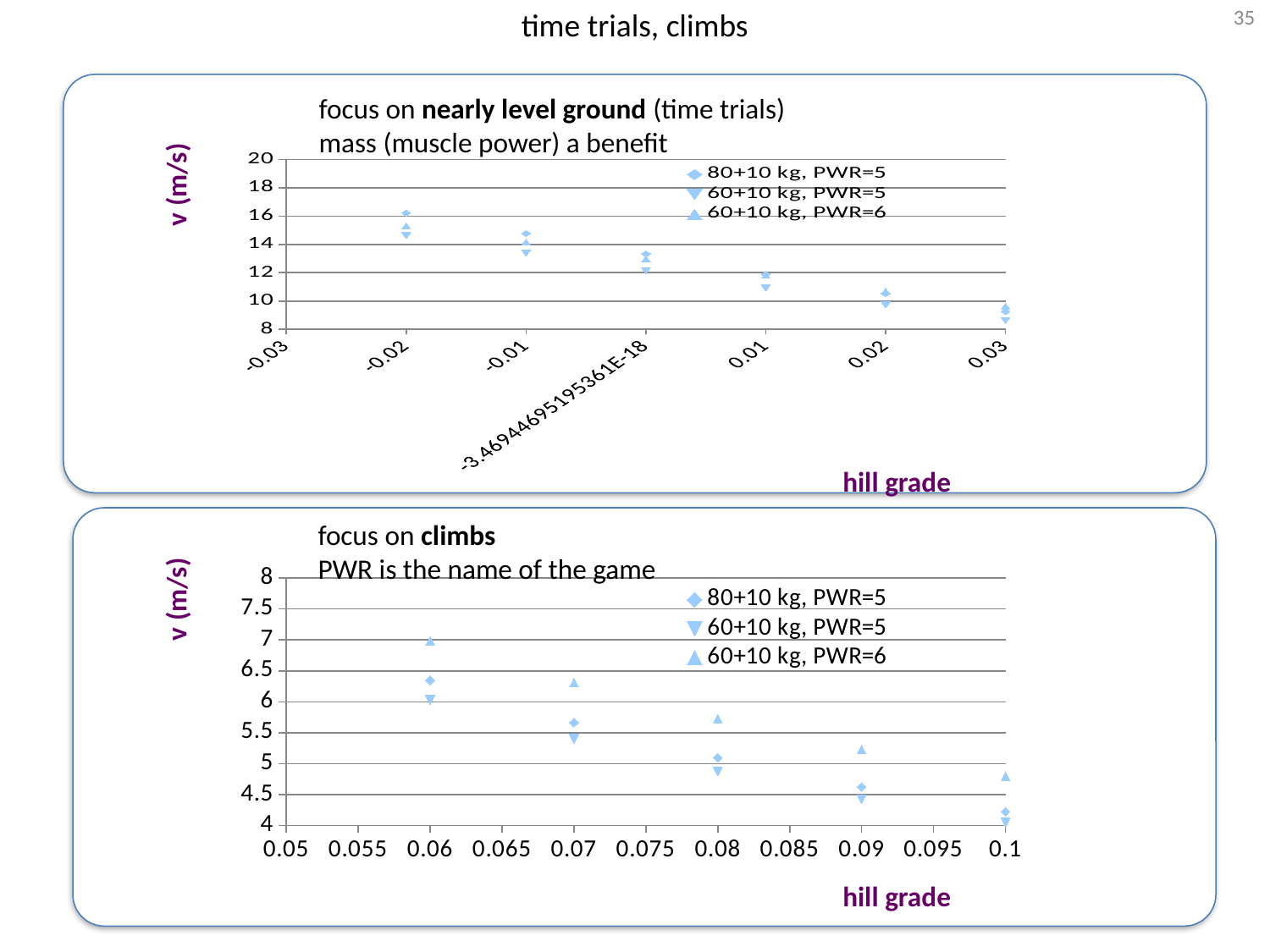
In the bottom chart (focus on climbs), is the value for 80+10 kg, PWR=5 at hill grade 0.1 greater or less than 4.5? less In the top chart (focus on nearly level ground), do the values for 60+10 kg, PWR=6 rise or fall as hill grade increases? fall In the bottom chart (focus on climbs), is the value for 60+10 kg, PWR=6 at hill grade 0.06 greater or less than 6.5? greater In the bottom chart (focus on climbs), how many data points are plotted for the 80+10 kg, PWR=5 series? 5 In the top chart (focus on nearly level ground), is the value for 60+10 kg, PWR=5 at hill grade 0.03 greater or less than 10? less In the bottom chart (focus on climbs), what kind of chart is shown? scatter chart In the bottom chart (focus on climbs), which series has the highest value at hill grade 0.1? 60+10 kg, PWR=6 In the bottom chart (focus on climbs), at hill grade 0.06, which is larger: the value for 60+10 kg, PWR=6 or the value for 60+10 kg, PWR=5? 60+10 kg, PWR=6 In the bottom chart (focus on climbs), do the values for 80+10 kg, PWR=5 rise or fall as hill grade increases? fall In the top chart (focus on nearly level ground), how many series does the legend list? 3 In the bottom chart (focus on climbs), what is the label of the y axis? v (m/s)